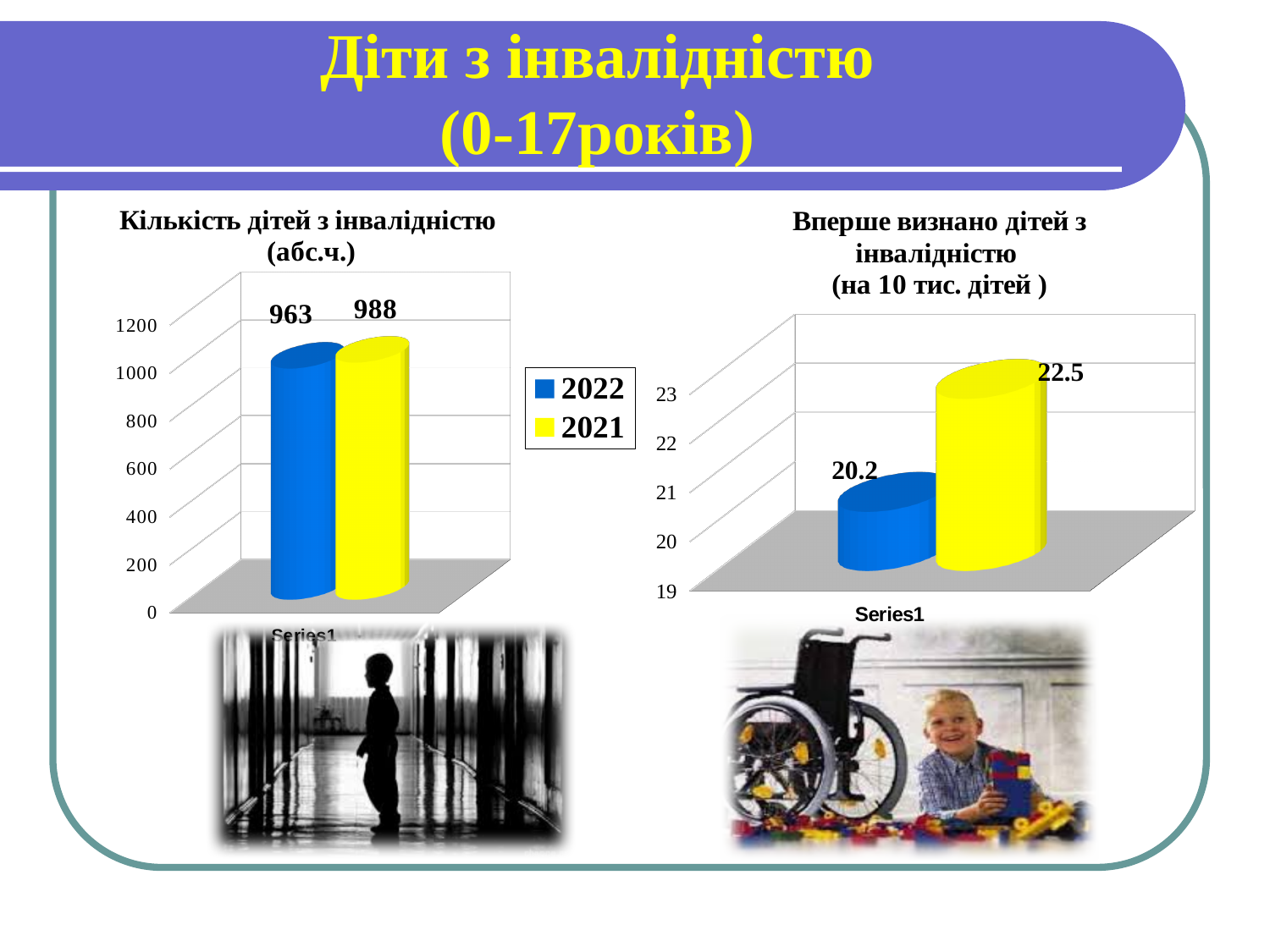
In the left chart (Кількість дітей з інвалідністю), what is the value for 2022? 963 Which colour represents 2021 in the legend? yellow In the right chart (Вперше визнано дітей з інвалідністю), what is the value for 2022? 20.2 In the right chart (Вперше визнано дітей з інвалідністю), which year has the lower value? 2022 In the left chart (Кількість дітей з інвалідністю), what is the value for 2021? 988 What kind of chart is the left chart (Кількість дітей з інвалідністю)? bar chart In the right chart (Вперше визнано дітей з інвалідністю), is the value for 2022 greater or less than 21? less How many series does the legend list? 2 In the right chart (Вперше визнано дітей з інвалідністю), what is the difference between the 2021 and 2022 values? 2.3 In the left chart (Кількість дітей з інвалідністю), which year has the higher value? 2021 In the right chart (Вперше визнано дітей з інвалідністю), what is the value for 2021? 22.5 In the left chart (Кількість дітей з інвалідністю), what is the difference between the 2021 and 2022 values? 25